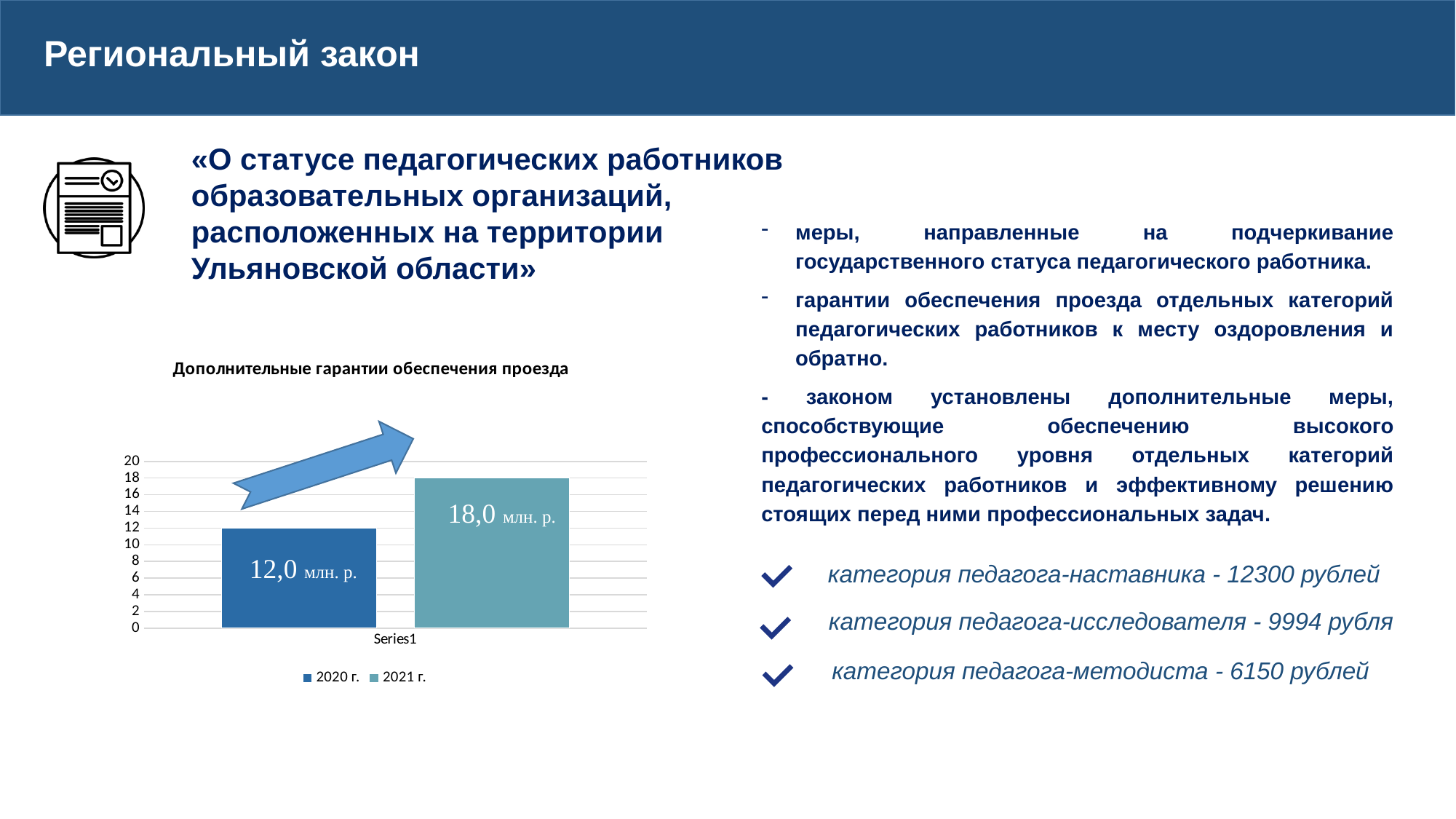
Which series has the lowest value in the chart? 2020 г. What is the difference between the 2021 г. and 2020 г. values? 6,0 млн. р. What is the value for 2020 г. in the chart? 12,0 млн. р. Do the values rise or fall from 2020 г. to 2021 г.? rise How many series does the legend list? 2 What is the title of the chart? Дополнительные гарантии обеспечения проезда What is the value for 2021 г. in the chart? 18,0 млн. р. Which series has the highest value in the chart? 2021 г. What type of chart is shown on the slide? bar chart Is the value for 2021 г. greater or less than 16? greater Is the value for 2020 г. greater or less than 14? less Which series has the higher value, 2020 г. or 2021 г.? 2021 г.